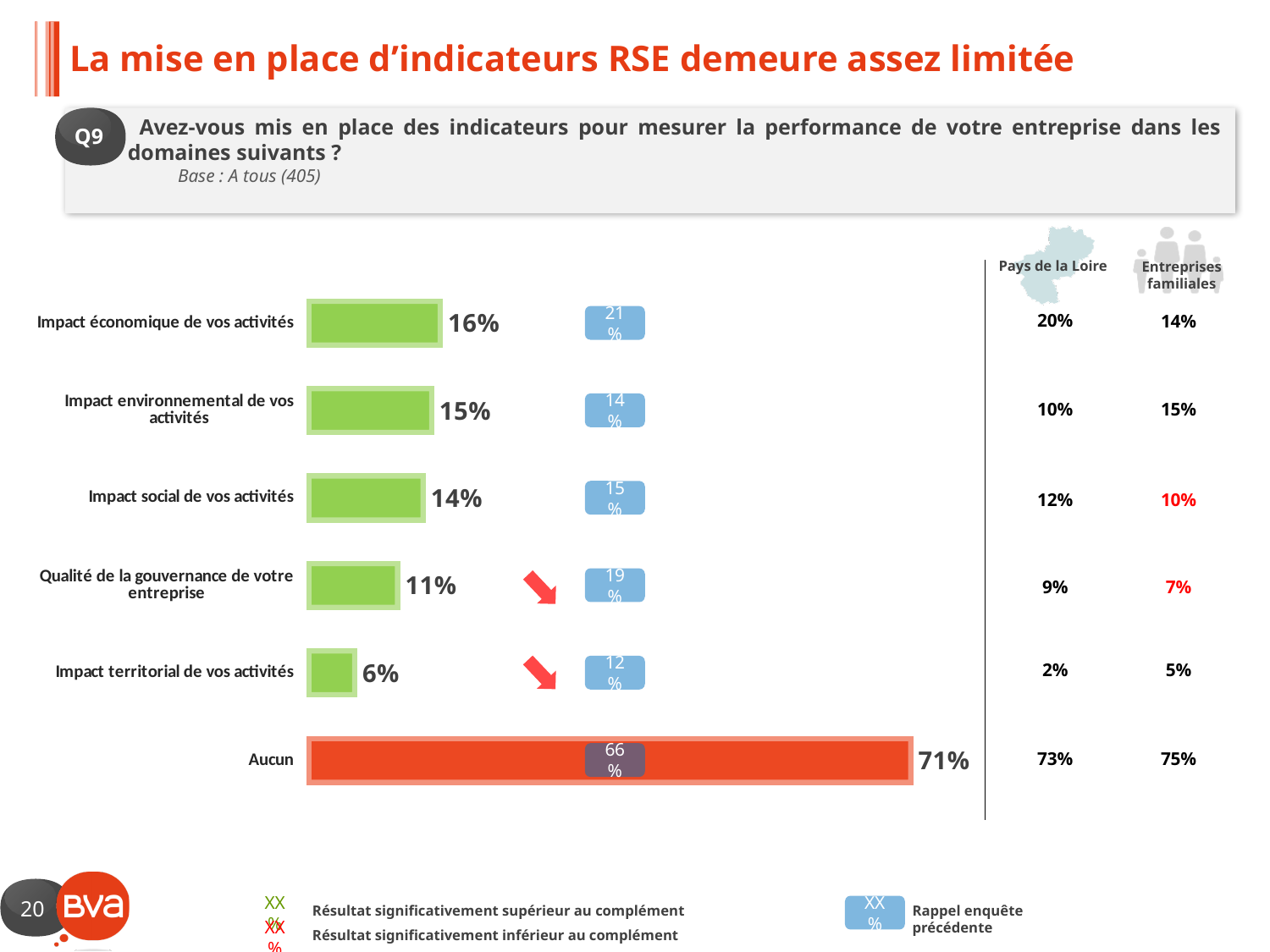
What is the value for "Aucun" in the bar chart? 71% Which category has the highest value in the bar chart? Aucun What is the "Pays de la Loire" value for "Aucun" in the table to the right of the chart? 73% What is the value for "Qualité de la gouvernance de votre entreprise" in the bar chart? 11% What kind of chart is shown on the slide? Bar chart Which is larger in the bar chart: "Impact environnemental de vos activités" or "Impact social de vos activités"? Impact environnemental de vos activités How many categories are shown in the bar chart? 6 What is the difference between the values for "Aucun" and "Impact économique de vos activités" in the bar chart? 55 percentage points What is the value for "Impact territorial de vos activités" in the bar chart? 6% What is the value for "Impact économique de vos activités" in the bar chart? 16% What was the previous survey value (blue box) for "Impact territorial de vos activités"? 12% Which category has the lowest value in the bar chart? Impact territorial de vos activités